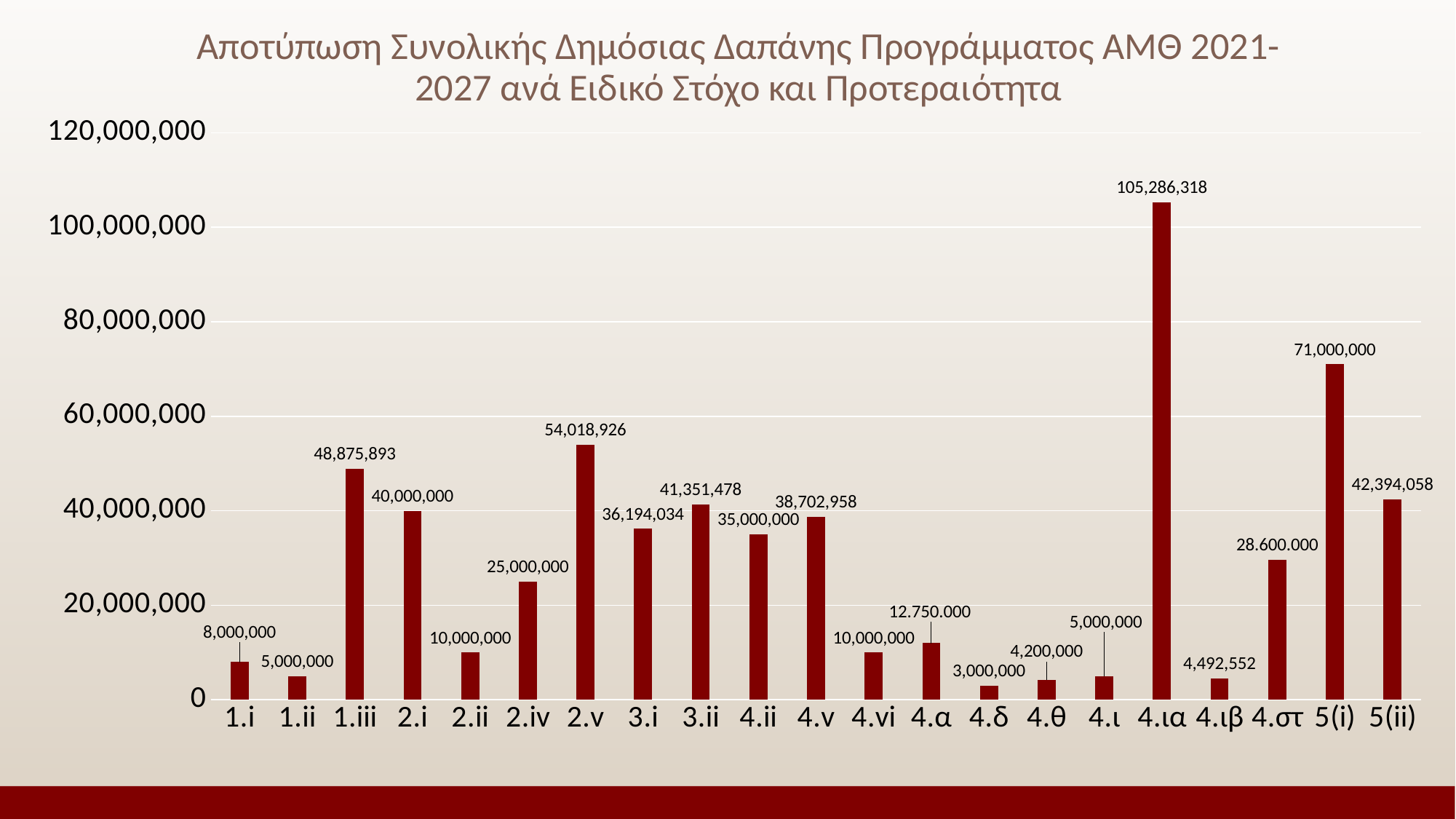
What is the difference between the values for 5(i) and 5(ii)? 28,605,942 Which category has the lowest value? 4.δ What is the value for 2.v? 54,018,926 What is the difference between the values for 2.i and 2.ii? 30,000,000 What is the value for 4.στ? 28.600.000 Which is larger, the value for 2.v or the value for 1.iii? 2.v What is the value for 4.ια? 105,286,318 How many categories are shown on the x axis? 21 Is the value for 3.i greater or less than 40,000,000? less What is the value for 5(ii)? 42,394,058 Which category has the highest value? 4.ια What kind of chart is shown on the slide? bar chart